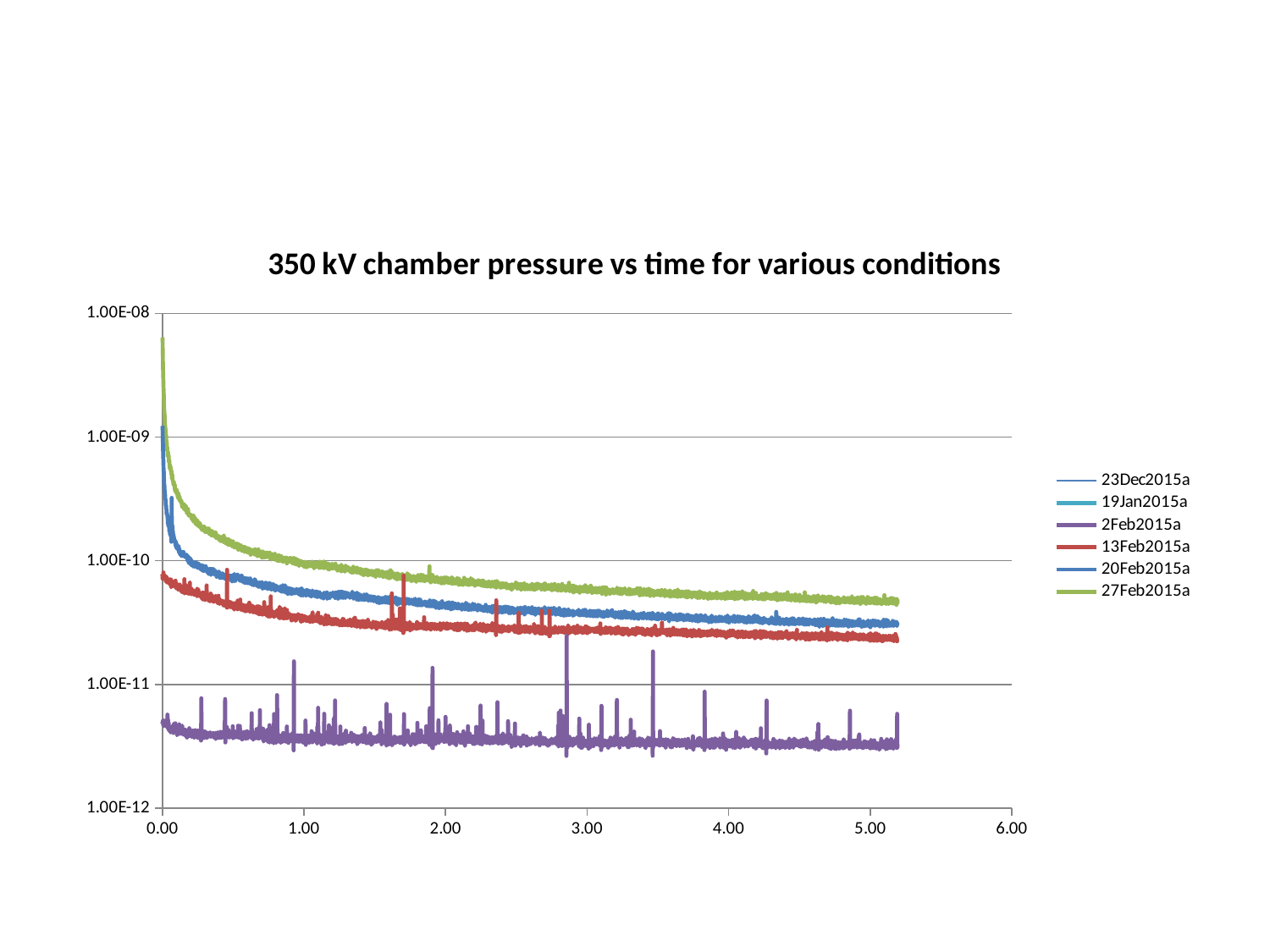
Which series has the lowest pressure values across the plotted range? 2Feb2015a What kind of chart is shown on the slide? line chart How many series does the legend list? 6 At time 2.00, which series has the larger value, 2Feb2015a or 27Feb2015a? 27Feb2015a Is the value for 27Feb2015a at time 0.50 greater or less than 1.00E-10? greater Does the 27Feb2015a series rise or fall as time increases along the x axis? fall At time 4.00, which series has the larger value, 13Feb2015a or 20Feb2015a? 20Feb2015a Is the value for 13Feb2015a at time 3.00 greater or less than 1.00E-10? less What is the title of the chart? 350 kV chamber pressure vs time for various conditions What colour is the 2Feb2015a series in the legend? purple Is the value for 2Feb2015a at time 3.00 greater or less than 1.00E-11? less Which series has the highest pressure values across the plotted range? 27Feb2015a